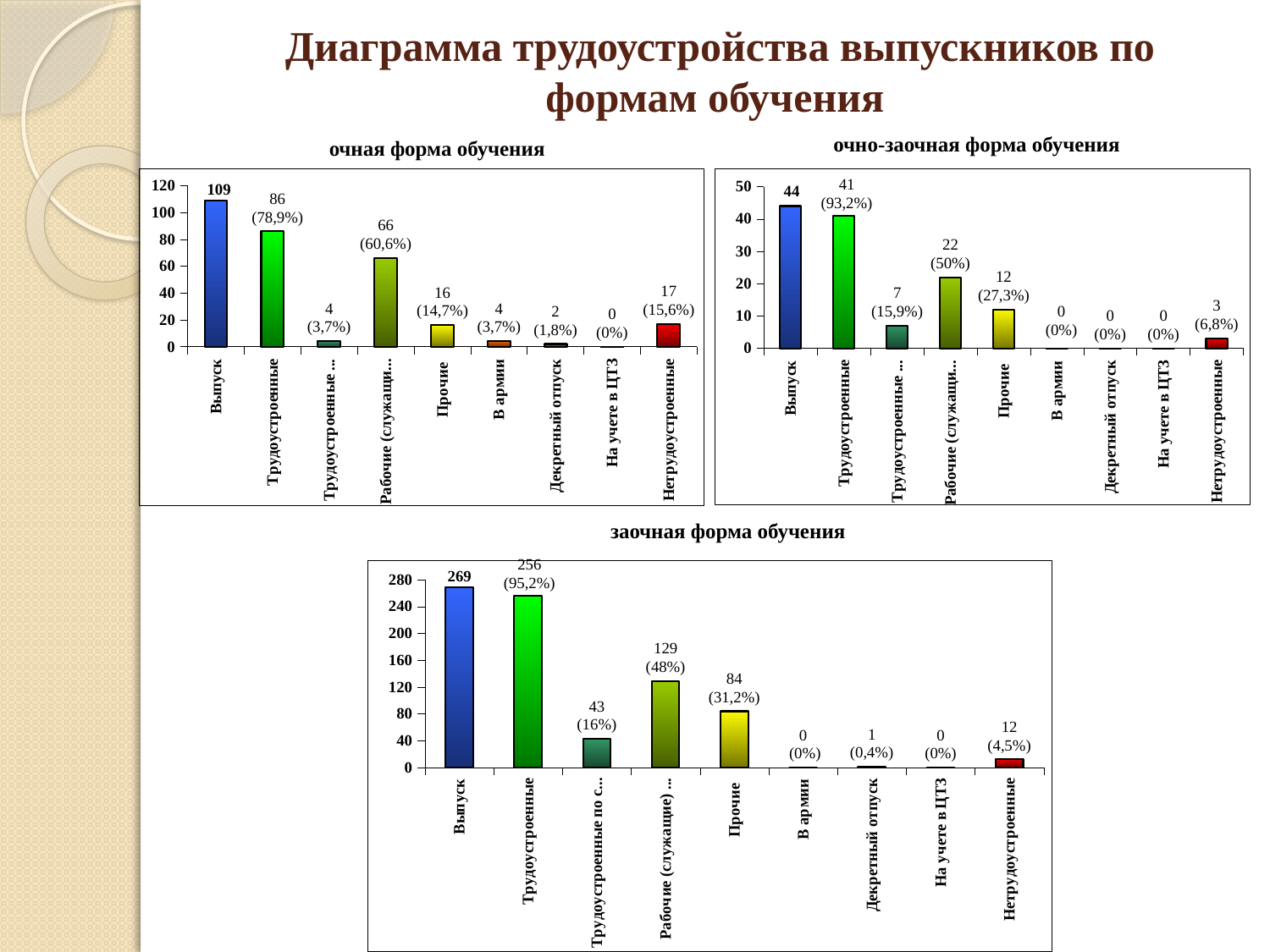
In the chart titled 'заочная форма обучения', what is the value for 'Прочие'? 84 In the chart titled 'заочная форма обучения', what is the difference between 'Выпуск' and 'Трудоустроенные'? 13 What type of chart is the chart titled 'заочная форма обучения'? Bar chart In the chart titled 'заочная форма обучения', which is larger, 'Прочие' or 'Нетрудоустроенные'? Прочие How many categories are shown in the chart titled 'очная форма обучения'? 9 In the chart titled 'очно-заочная форма обучения', what is the difference between 'Выпуск' and 'Трудоустроенные'? 3 In the chart titled 'очно-заочная форма обучения', what is the value for 'Прочие'? 12 In the chart titled 'заочная форма обучения', what percentage is shown for 'Нетрудоустроенные'? 4,5% In the chart titled 'очная форма обучения', what is the value for 'Выпуск'? 109 In the chart titled 'очно-заочная форма обучения', which category has the highest value? Выпуск In the chart titled 'очная форма обучения', what percentage is shown for 'Трудоустроенные'? 78,9% In the chart titled 'очная форма обучения', what is the value for 'Нетрудоустроенные'? 17